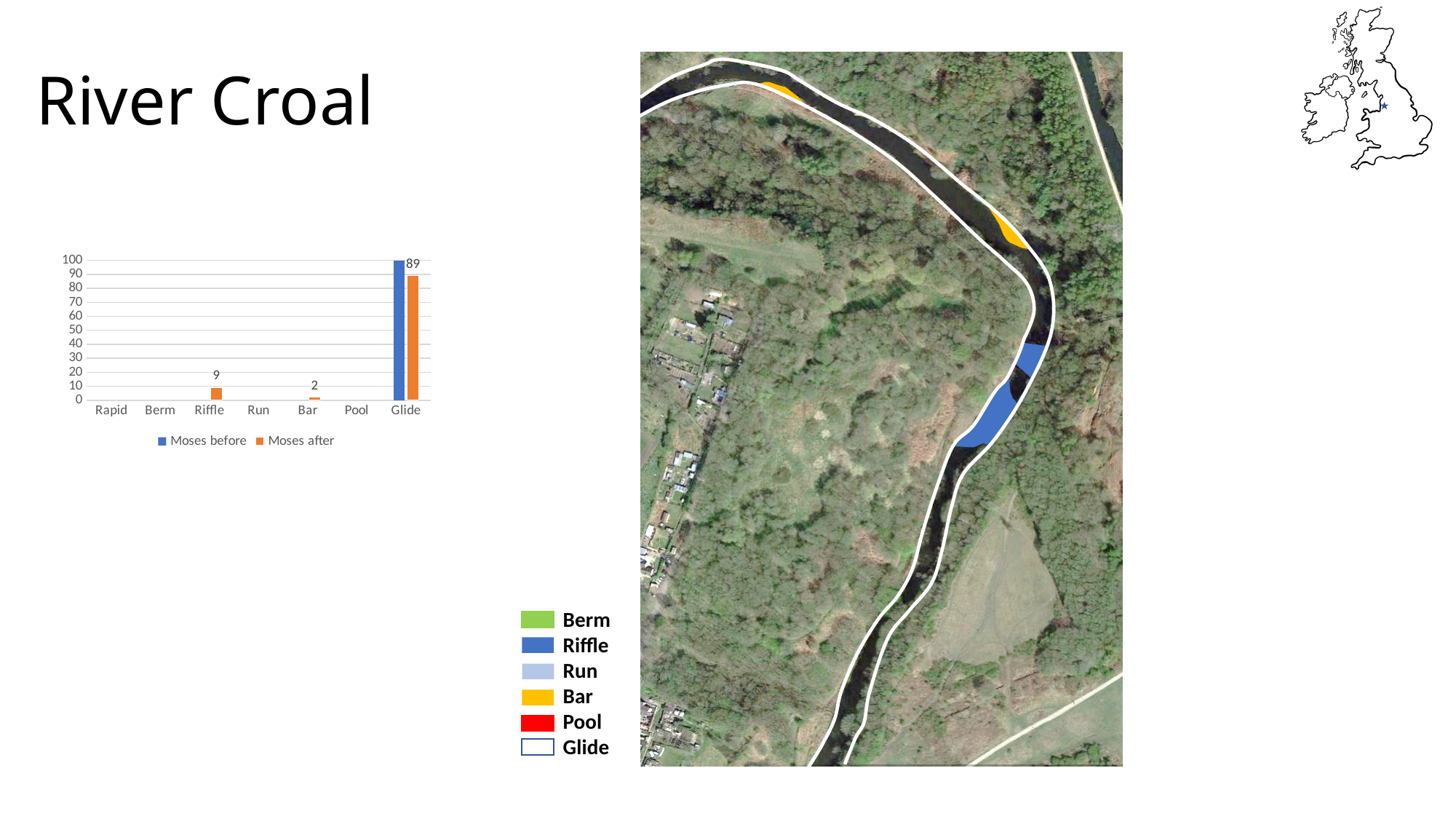
For Moses after, which is larger: Riffle or Bar? Riffle How many series does the chart legend list? 2 What is the Moses after value for Bar? 2 What kind of chart is shown on the slide? Bar chart How many categories are shown on the x axis of the bar chart? 7 What is the Moses after value for Glide? 89 What are the two series named in the chart legend? Moses before and Moses after What is the Moses after value for Riffle? 9 Which category has the highest Moses after value? Glide For Glide, which series has the larger value: Moses before or Moses after? Moses before Is the Moses before value for Glide greater or less than 50? greater What is the difference between the Moses after values for Riffle and Bar? 7